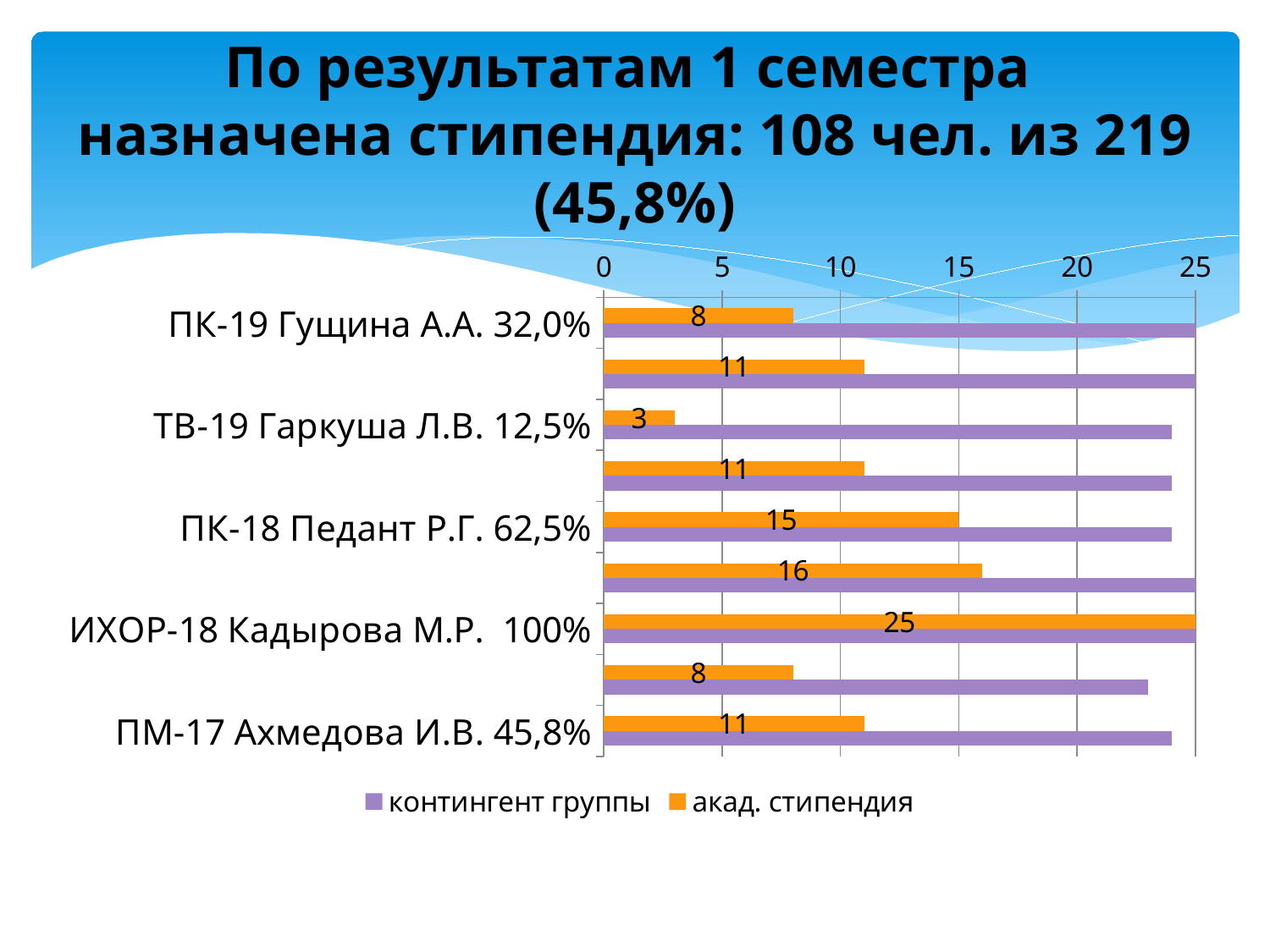
What is the difference between the акад. стипендия values for ИХОР-18 Кадырова М.Р. 100% and ТВ-19 Гаркуша Л.В. 12,5%? 22 What is the value of акад. стипендия for ПК-19 Гущина А.А. 32,0%? 8 What is the value of акад. стипендия for ПК-18 Педант Р.Г. 62,5%? 15 Which labelled group has the highest акад. стипендия value? ИХОР-18 Кадырова М.Р. 100% What kind of chart is shown on the slide? bar chart What is the value of акад. стипендия for ТВ-19 Гаркуша Л.В. 12,5%? 3 What is the value of акад. стипендия for ПМ-17 Ахмедова И.В. 45,8%? 11 Is the контингент группы value for ПК-19 Гущина А.А. 32,0% greater or less than 20? greater How many series does the legend list? 2 What is the value of акад. стипендия for ИХОР-18 Кадырова М.Р. 100%? 25 Which has the larger акад. стипендия value: ПК-18 Педант Р.Г. 62,5% or ПМ-17 Ахмедова И.В. 45,8%? ПК-18 Педант Р.Г. 62,5% Which labelled group has the lowest акад. стипендия value? ТВ-19 Гаркуша Л.В. 12,5%